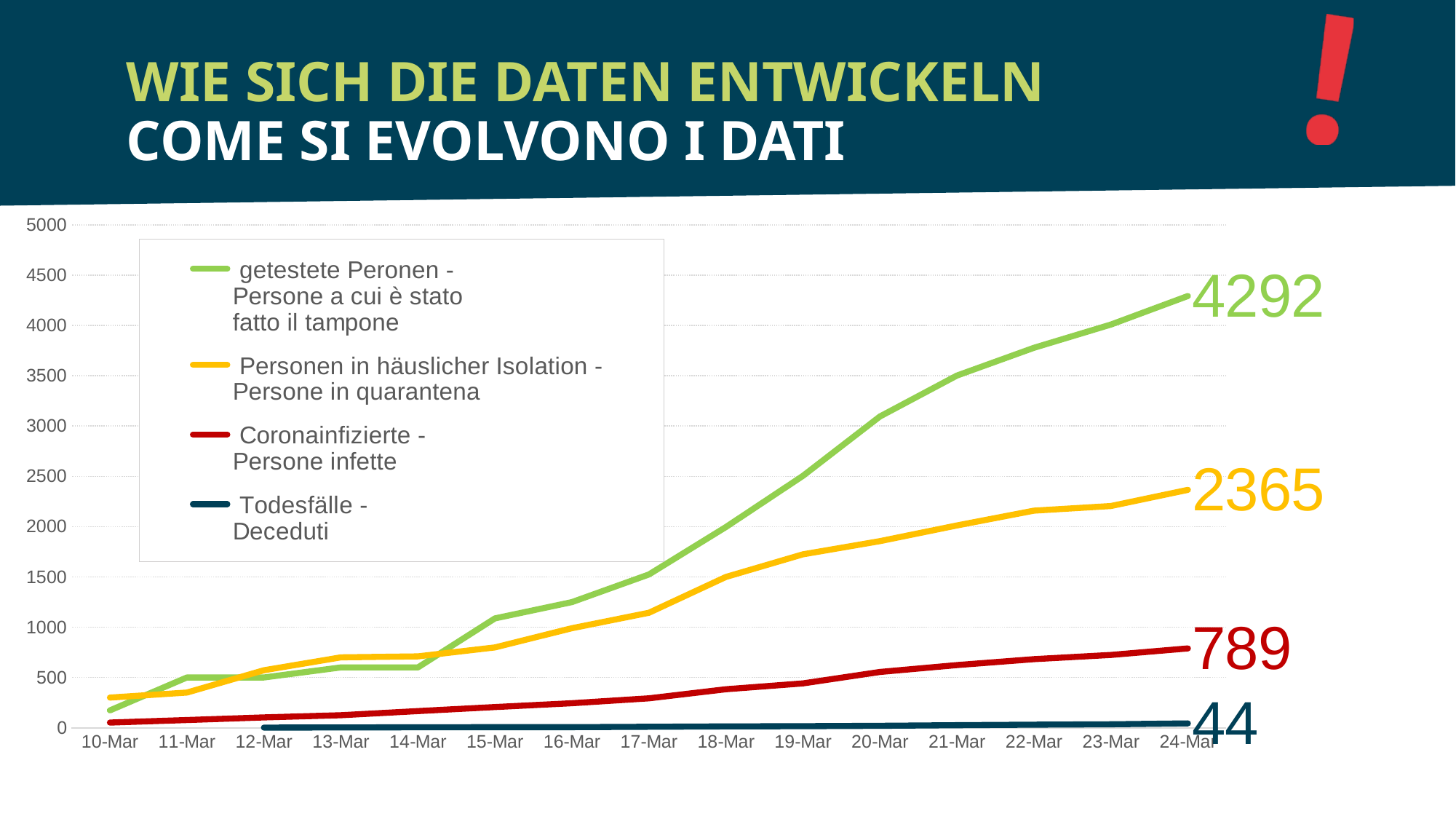
How many series does the legend list? 4 Which series has the lowest value on 24-Mar? Todesfälle - Deceduti How many dates are shown on the x axis? 15 What is the value labelled at the end of the 'Personen in häuslicher Isolation - Persone in quarantena' line on 24-Mar? 2365 What is the difference between the 24-Mar values of the tested persons line (4292) and the quarantine line (2365)? 1927 What is the value labelled at the end of the 'getestete Peronen - Persone a cui è stato fatto il tampone' line on 24-Mar? 4292 Which series has the highest value on 24-Mar? getestete Peronen - Persone a cui è stato fatto il tampone Does the 'Coronainfizierte - Persone infette' line rise or fall from 10-Mar to 24-Mar? rise What is the value labelled at the end of the 'Todesfälle - Deceduti' line on 24-Mar? 44 Is the value of the 'getestete Peronen' line on 20-Mar greater or less than 3000? greater What kind of chart is shown on the slide? line chart What is the value labelled at the end of the 'Coronainfizierte - Persone infette' line on 24-Mar? 789